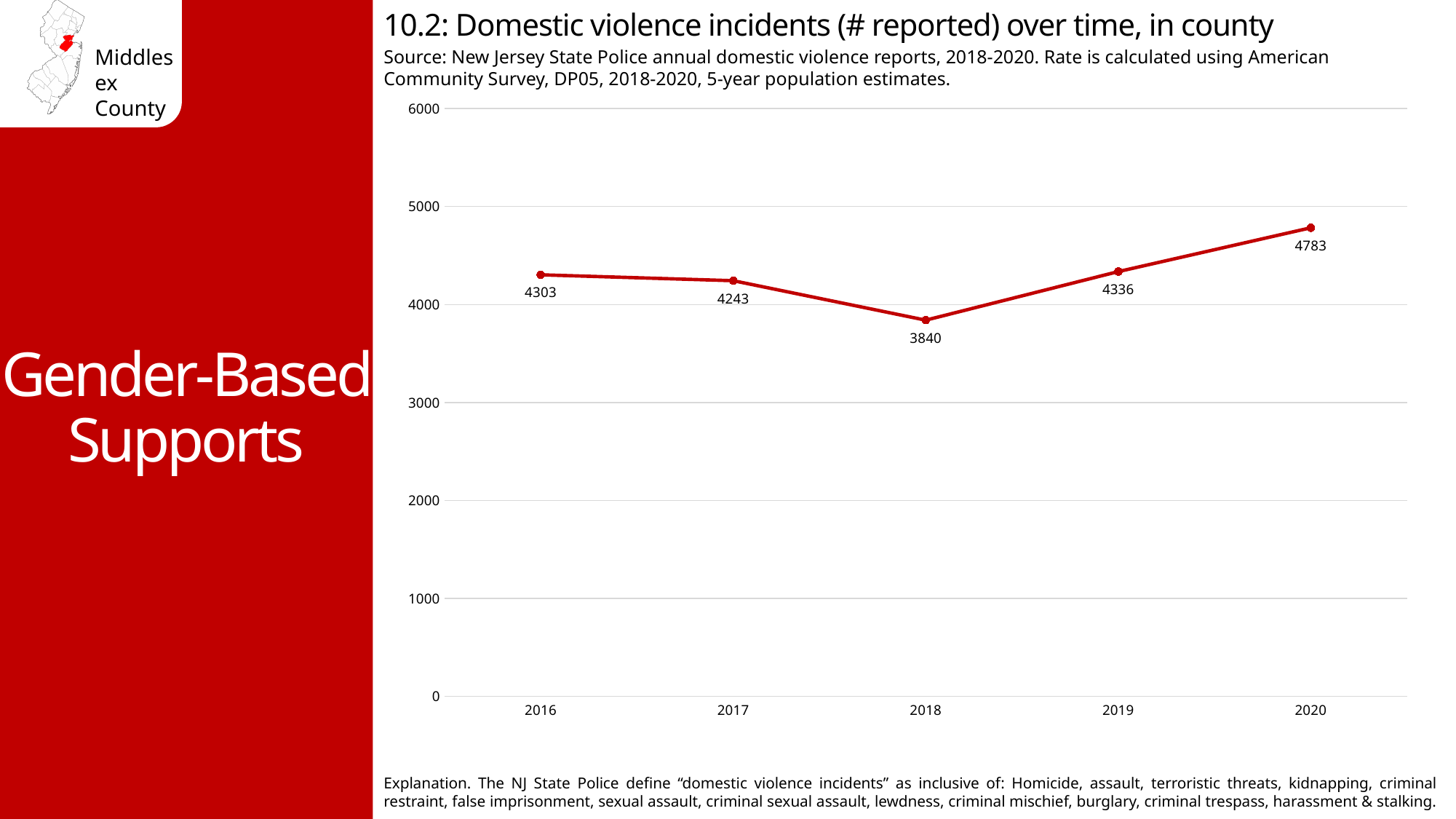
Which year had the lowest number of reported domestic violence incidents? 2018 Did the number of reported incidents rise or fall from 2018 to 2020? rise What was the number of reported domestic violence incidents in 2020? 4783 Which year had the highest number of reported domestic violence incidents? 2020 Is the value for 2018 greater or less than 4000? less What is the difference between the number of incidents in 2020 and in 2018? 943 What kind of chart is shown on the slide? line chart What was the number of reported domestic violence incidents in 2018? 3840 What is the difference between the number of incidents in 2016 and in 2017? 60 Which year had more reported incidents, 2019 or 2017? 2019 How many years are plotted on the chart? 5 What was the number of reported domestic violence incidents in 2016? 4303